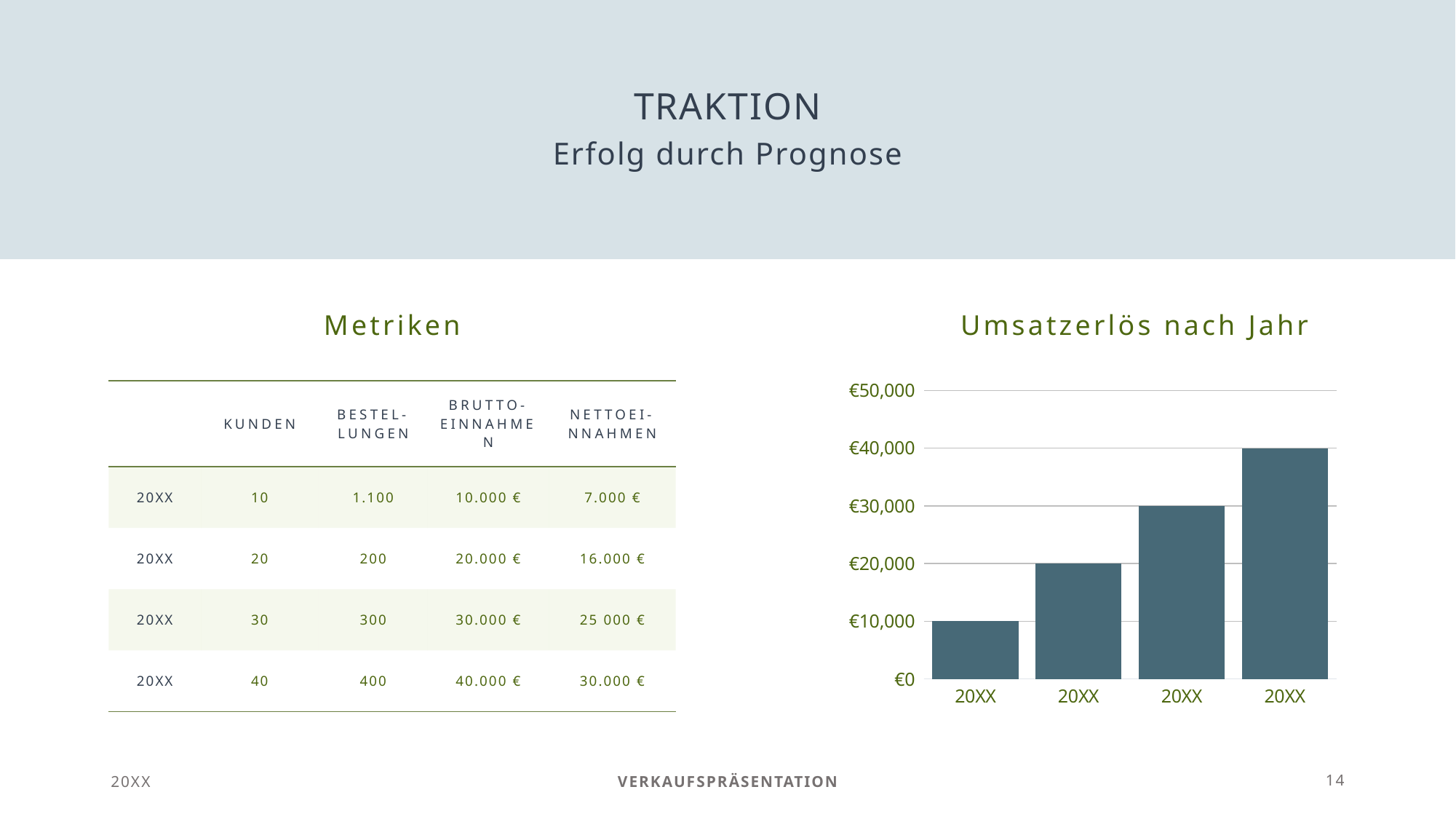
In the "Umsatzerlös nach Jahr" chart, which bar is the highest? The rightmost (fourth) bar In the "Umsatzerlös nach Jahr" chart, do the values rise or fall from left to right? Rise What is the title of the chart on the right side of the slide? Umsatzerlös nach Jahr In the "Umsatzerlös nach Jahr" chart, what is the value of the second bar from the left? €20,000 In the "Umsatzerlös nach Jahr" chart, what is the value of the third bar from the left? €30,000 In the "Umsatzerlös nach Jahr" chart, what is the value of the leftmost bar? €10,000 What kind of chart is shown under the title "Umsatzerlös nach Jahr"? Bar chart How many bars does the "Umsatzerlös nach Jahr" chart show? 4 In the "Umsatzerlös nach Jahr" chart, what is the difference between the rightmost bar and the leftmost bar? €30,000 In the "Umsatzerlös nach Jahr" chart, is the third bar from the left larger or smaller than the second bar? Larger In the "Umsatzerlös nach Jahr" chart, what is the value of the rightmost bar? €40,000 In the "Umsatzerlös nach Jahr" chart, which bar is the lowest? The leftmost (first) bar